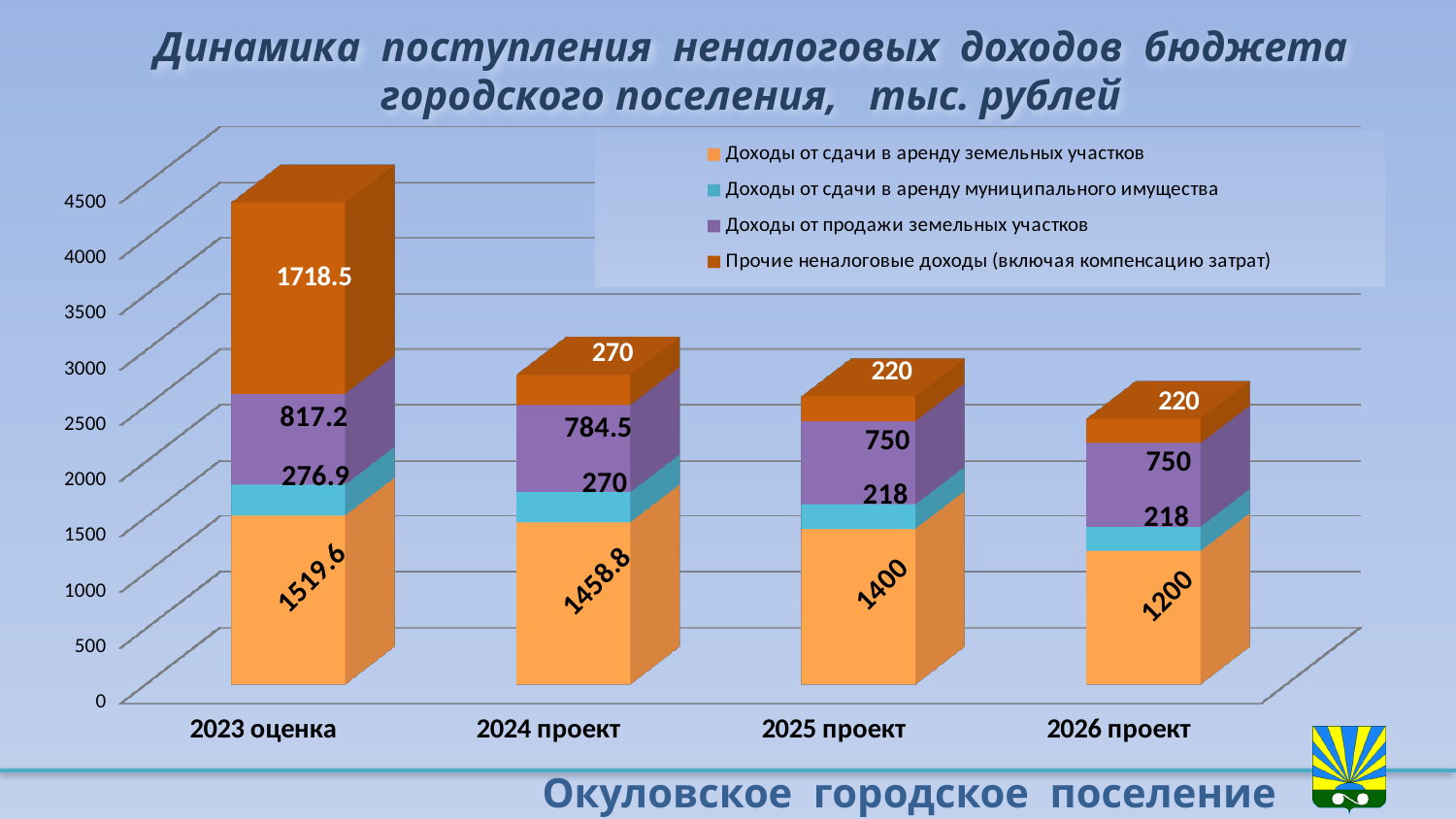
What kind of chart is shown on the slide? stacked bar chart What is the value of 'Доходы от продажи земельных участков' for 2024 проект? 784.5 What is the total of the stacked bar for 2025 проект? 2588 What is the difference between 'Доходы от сдачи в аренду земельных участков' for 2023 оценка and 2026 проект? 319.6 How many categories are shown on the x axis? 4 Which category has the highest value for 'Доходы от сдачи в аренду земельных участков'? 2023 оценка How many series does the legend list? 4 What is the value of 'Доходы от сдачи в аренду земельных участков' for 2023 оценка? 1519.6 What is the value of 'Доходы от сдачи в аренду муниципального имущества' for 2025 проект? 218 Does the value of 'Доходы от сдачи в аренду земельных участков' rise or fall from 2023 оценка to 2026 проект? fall Which category has the lowest value for 'Доходы от сдачи в аренду земельных участков'? 2026 проект What is the value of 'Прочие неналоговые доходы (включая компенсацию затрат)' for 2023 оценка? 1718.5